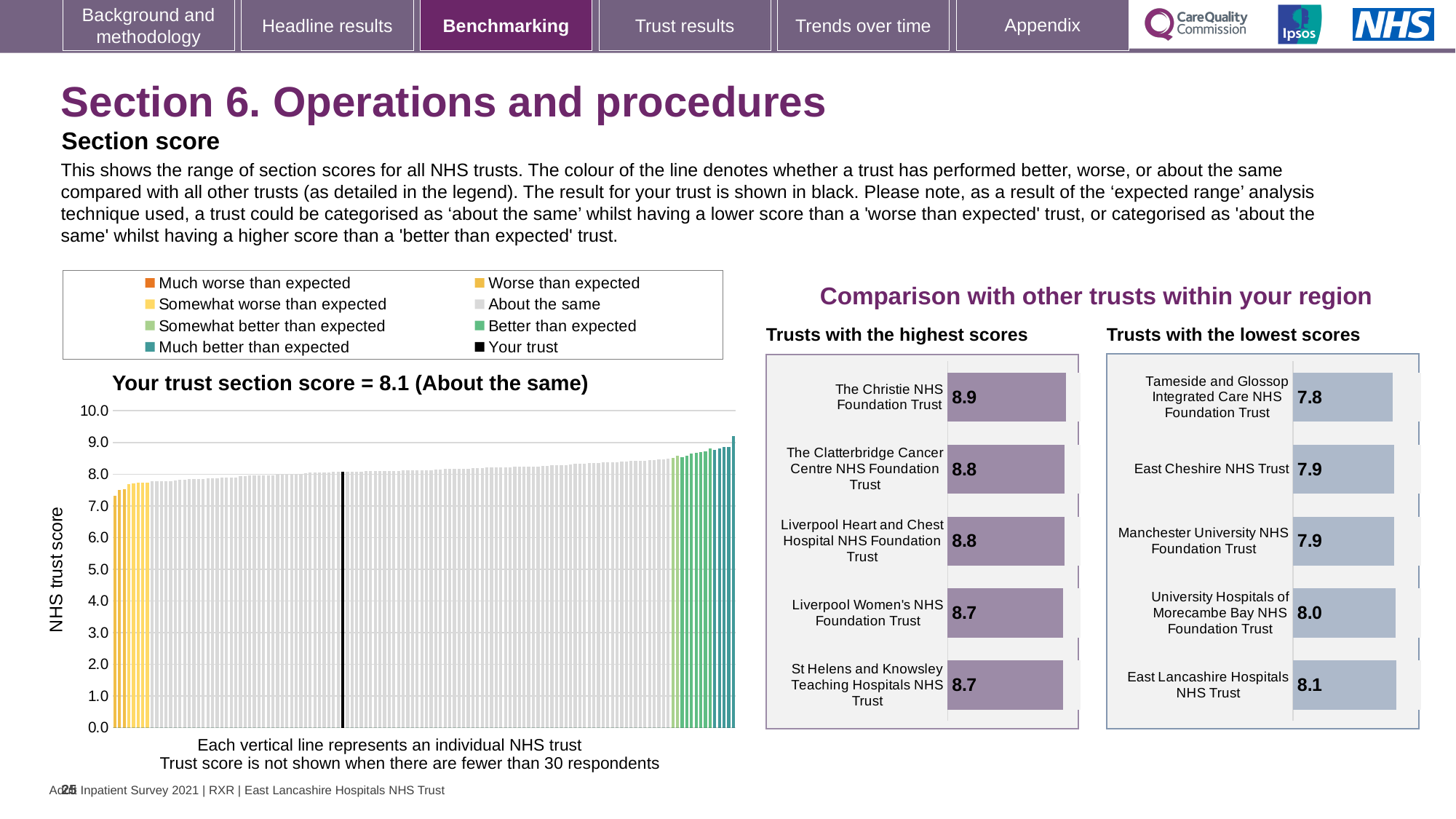
In the 'Trusts with the lowest scores' chart, which trust has the lowest score? Tameside and Glossop Integrated Care NHS Foundation Trust In the 'Trusts with the highest scores' chart, what is the score for Liverpool Women's NHS Foundation Trust? 8.7 In the 'Trusts with the lowest scores' chart, what is the difference between the scores of East Lancashire Hospitals NHS Trust and Tameside and Glossop Integrated Care NHS Foundation Trust? 0.3 In the 'Trusts with the lowest scores' chart, what is the score for Tameside and Glossop Integrated Care NHS Foundation Trust? 7.8 What kind of chart is the 'Your trust section score' chart on the left of the slide? Bar chart How many entries does the legend above the 'Your trust section score' chart list? 8 In the 'Trusts with the highest scores' chart, what is the difference between the scores of The Christie NHS Foundation Trust and Liverpool Women's NHS Foundation Trust? 0.2 How many trusts are listed in the 'Trusts with the highest scores' chart? 5 In the 'Trusts with the lowest scores' chart, which has the larger score: East Lancashire Hospitals NHS Trust or Tameside and Glossop Integrated Care NHS Foundation Trust? East Lancashire Hospitals NHS Trust In the 'Trusts with the highest scores' chart, which trust has the highest score? The Christie NHS Foundation Trust In the 'Trusts with the highest scores' chart, what is the score for The Christie NHS Foundation Trust? 8.9 In the 'Trusts with the lowest scores' chart, what is the score for East Lancashire Hospitals NHS Trust? 8.1